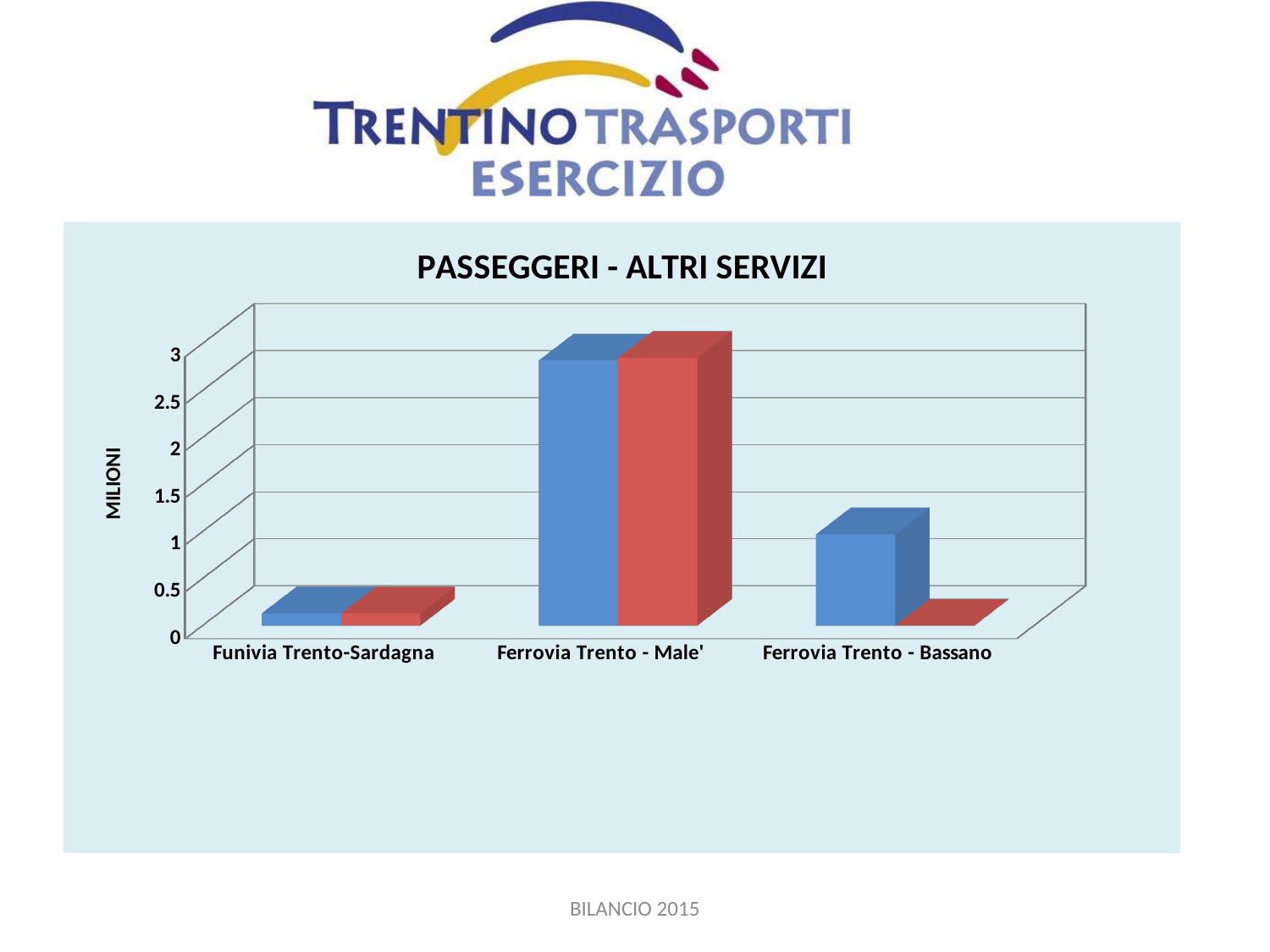
How many categories are shown on the x axis of the chart? 3 Which category has the highest bars in the chart? Ferrovia Trento - Male' What is the label of the vertical axis of the chart? MILIONI Is the red bar for Ferrovia Trento - Bassano greater or less than 0.5? less What is the title of the chart? PASSEGGERI - ALTRI SERVIZI Which category has the lowest blue bar in the chart? Funivia Trento-Sardagna What kind of chart is shown on the slide? bar chart Which has the larger blue bar, Ferrovia Trento - Male' or Ferrovia Trento - Bassano? Ferrovia Trento - Male' Is the red bar for Ferrovia Trento - Male' greater or less than 2? greater Is the blue bar for Ferrovia Trento - Male' greater or less than 2? greater